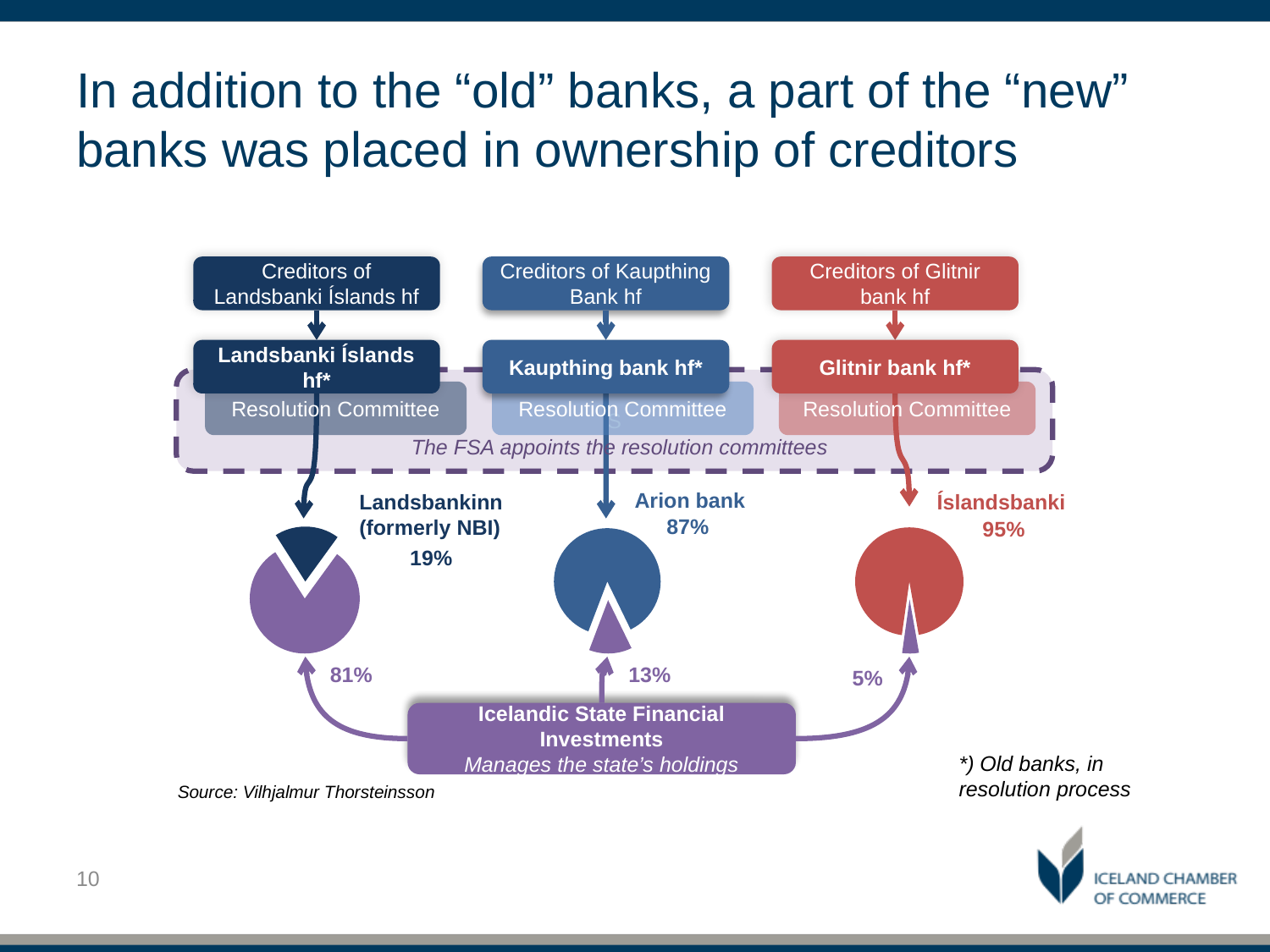
Is the state's share in Arion bank larger or smaller than the state's share in Landsbankinn (formerly NBI)? smaller In the Arion bank pie chart, what share is held by the creditors of Kaupthing Bank hf? 87% In the Íslandsbanki pie chart, what share is held by the creditors of Glitnir bank hf? 95% Which of the three new banks has the largest share held by the Icelandic State Financial Investments? Landsbankinn (formerly NBI) How many pie charts are shown on the slide? 3 Which of the three new banks has the smallest share held by the Icelandic State Financial Investments? Íslandsbanki In the Íslandsbanki pie chart, what share is held by the Icelandic State Financial Investments? 5% In the Arion bank pie chart, what share is held by the Icelandic State Financial Investments? 13% In the Landsbankinn (formerly NBI) pie chart, what share is held by the creditors of Landsbanki Íslands hf? 19% In the Landsbankinn (formerly NBI) pie chart, what share is held by the Icelandic State Financial Investments? 81% What kind of chart is used to show the ownership split of each new bank? Pie chart What is the difference between the creditors' share in Íslandsbanki and the creditors' share in Arion bank? 8%